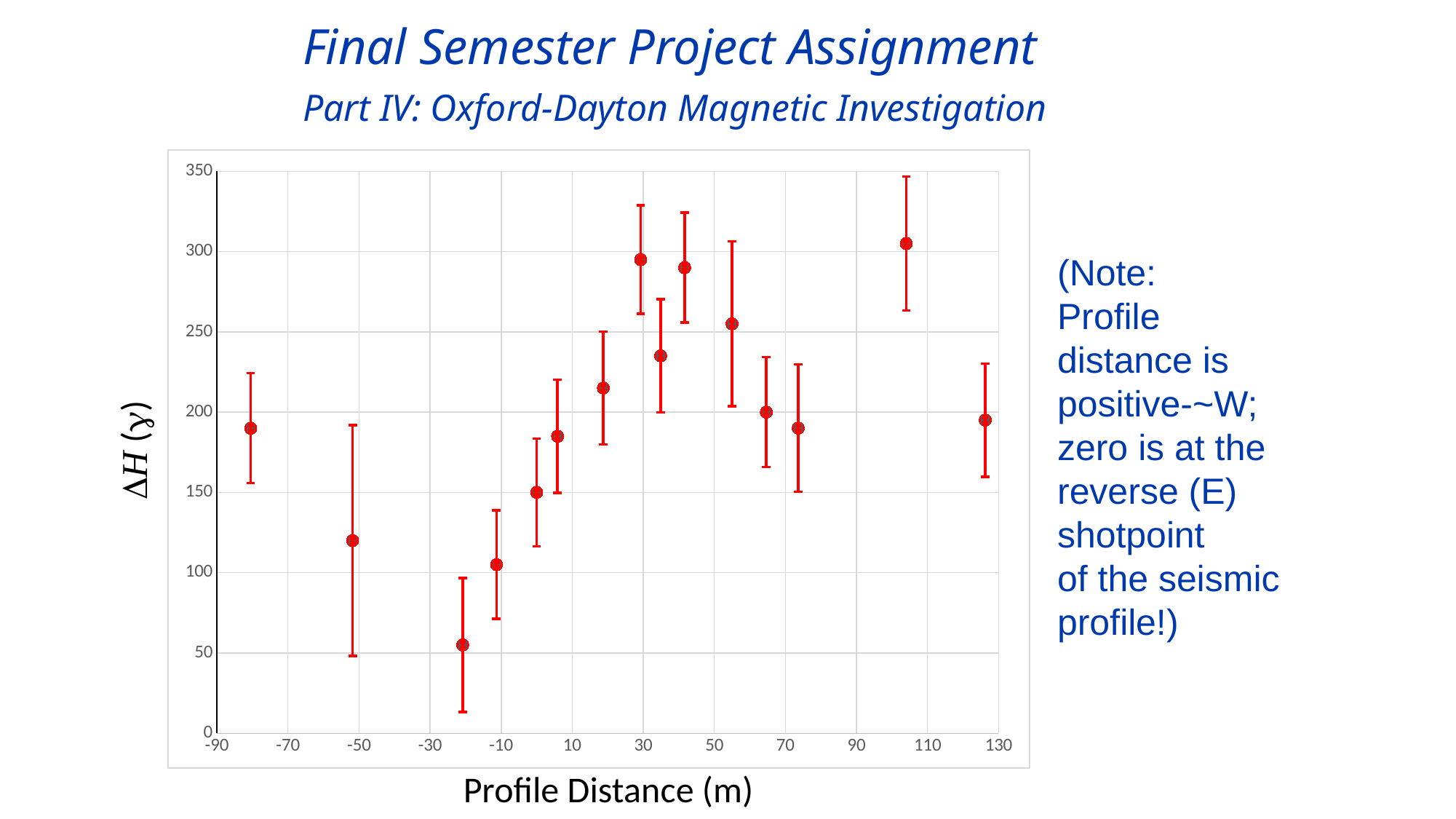
Do the ΔH values generally rise or fall as profile distance increases from -20 m to 30 m? Rise Is the ΔH value for the point near 30 m greater or less than 250? greater How many data points are plotted on the chart? 15 Is the ΔH value for the point near -20 m greater or less than 100? less Is the ΔH value for the point near 125 m greater or less than 250? less What kind of chart is shown on the slide? Scatter plot Which point has a higher ΔH value: the one near 30 m or the one near 70 m? The one near 30 m What is the label of the x axis? Profile Distance (m) What colour are the plotted points and error bars? Red Which point has the lowest ΔH value: the one near -20 m or the one near -50 m? The one near -20 m